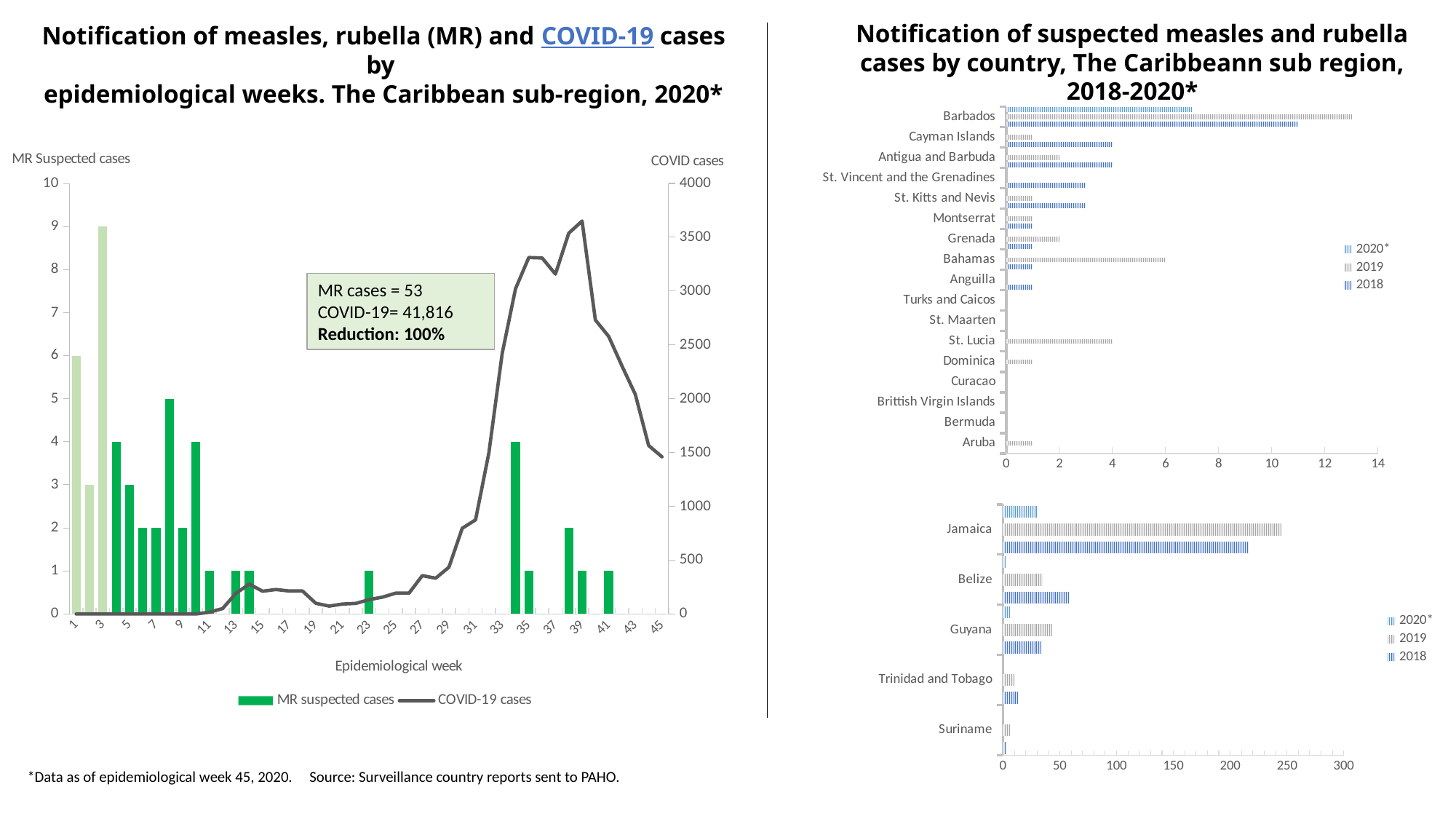
On the left chart, in which epidemiological week is the number of MR suspected cases highest? Week 3 On the left chart, how many MR suspected cases are shown for epidemiological week 34? 4 On the left chart, is the number of COVID-19 cases at epidemiological week 45 greater or less than 2000? less On the left chart, what is the total number of MR cases stated in the text box? 53 On the left chart, how many series does the legend list? 2 On the top-right chart, how many suspected cases are shown for the Bahamas in 2019? 6 On the top-right chart (Notification of suspected measles and rubella cases by country, 2018-2020), how many countries are listed on the vertical axis? 17 On the bottom-right chart, is the value for Jamaica in 2019 greater or less than 200? greater On the left chart, how many MR suspected cases are shown for epidemiological week 3? 9 On the left chart, what is the total number of COVID-19 cases stated in the text box? 41,816 On the top-right chart, which country has the highest number of suspected cases in 2019? Barbados On the left chart (Notification of measles, rubella and COVID-19 cases by epidemiological weeks), what kind of chart is it? A combination bar and line chart